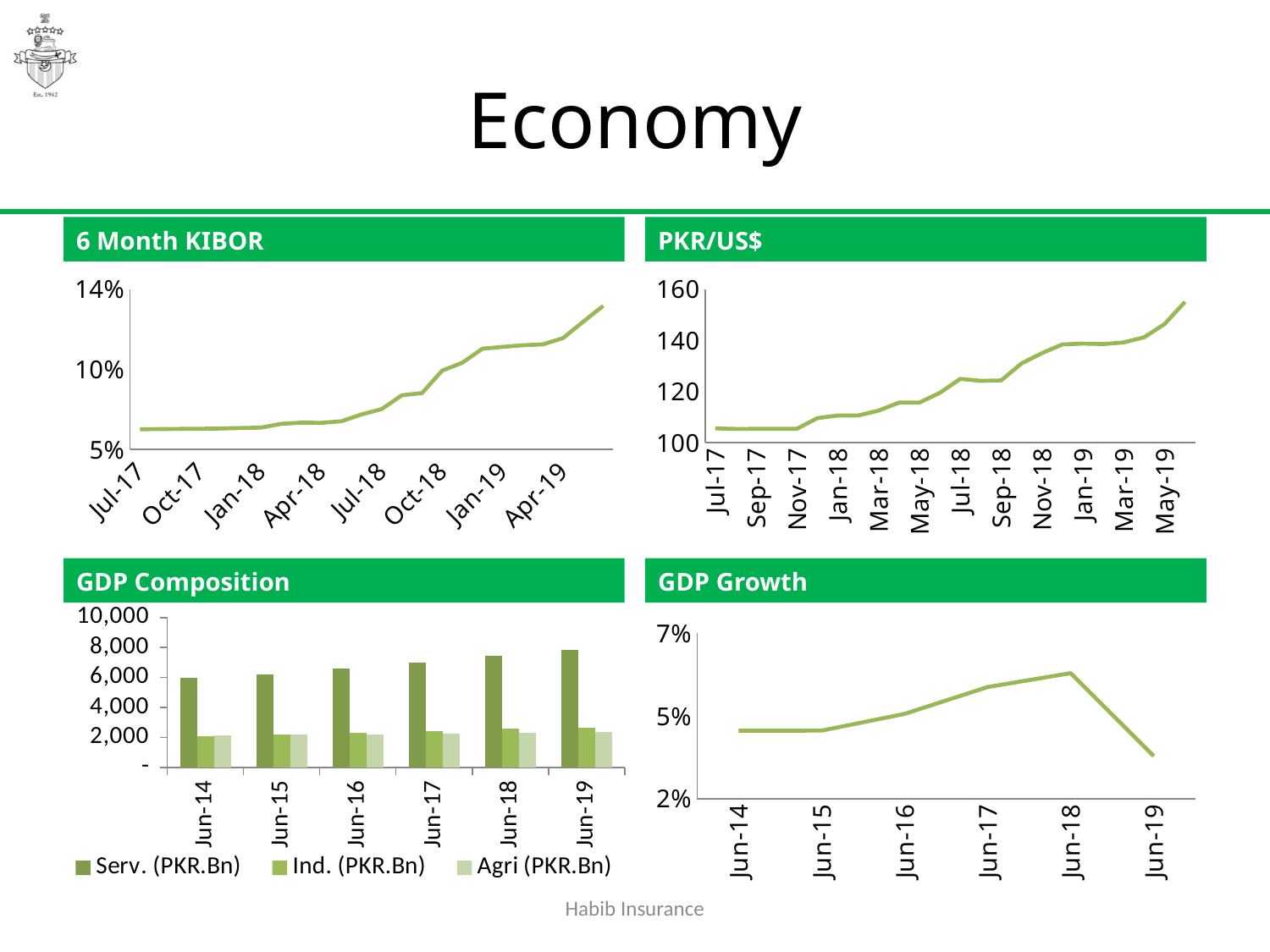
In the GDP Growth chart, is the value for Jun-19 greater or less than 5%? less In the PKR/US$ chart, is the value for Jul-17 greater or less than 120? less What kind of chart is the 6 Month KIBOR chart? line chart How many series does the legend of the GDP Composition chart list? 3 In the PKR/US$ chart, is the value for May-19 greater or less than 140? greater In the GDP Growth chart, which year has the highest value? Jun-18 In the 6 Month KIBOR chart, do the values rise or fall from Jul-17 to Apr-19? rise In the GDP Growth chart, which year has the lowest value? Jun-19 In the GDP Composition chart, which series has the highest value in Jun-19? Serv. (PKR.Bn) How many categories are shown on the x axis of the GDP Composition chart? 6 What kind of chart is the GDP Composition chart? bar chart